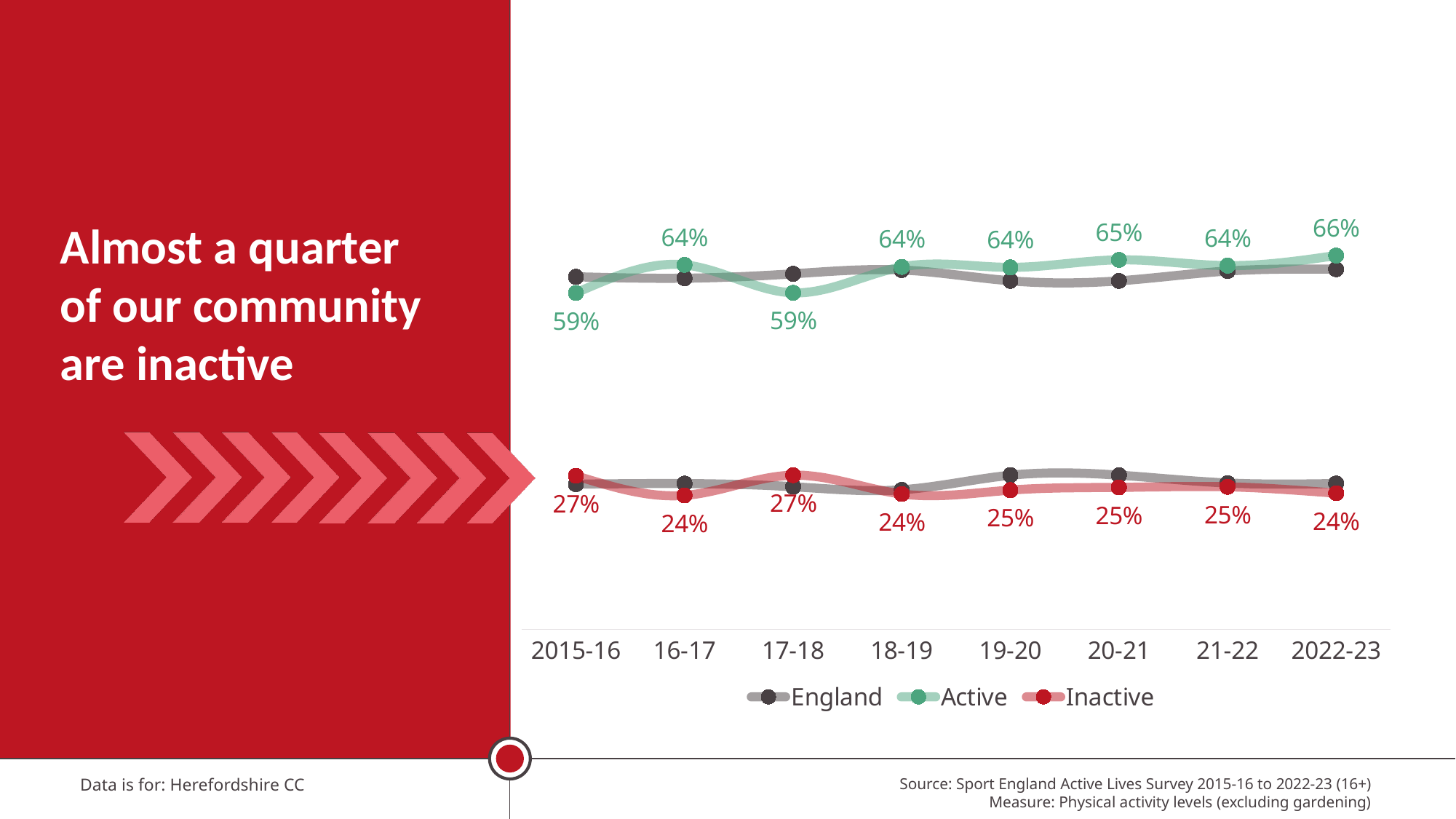
How many series does the legend list? 3 Which is larger: the Inactive value for 17-18 or the Inactive value for 18-19? 17-18 What is the Active value for 2022-23? 66% Which series is shown in green in the legend? Active In which period is the Active value highest? 2022-23 What is the Inactive value for 20-21? 25% What is the Inactive value for 2015-16? 27% What is the Active value for 17-18? 59% What is the difference between the Inactive value in 2015-16 and the Inactive value in 2022-23? 3% What kind of chart is shown on the slide? Line chart What is the difference between the Active value in 2022-23 and the Active value in 2015-16? 7% How many periods are shown on the x axis? 8